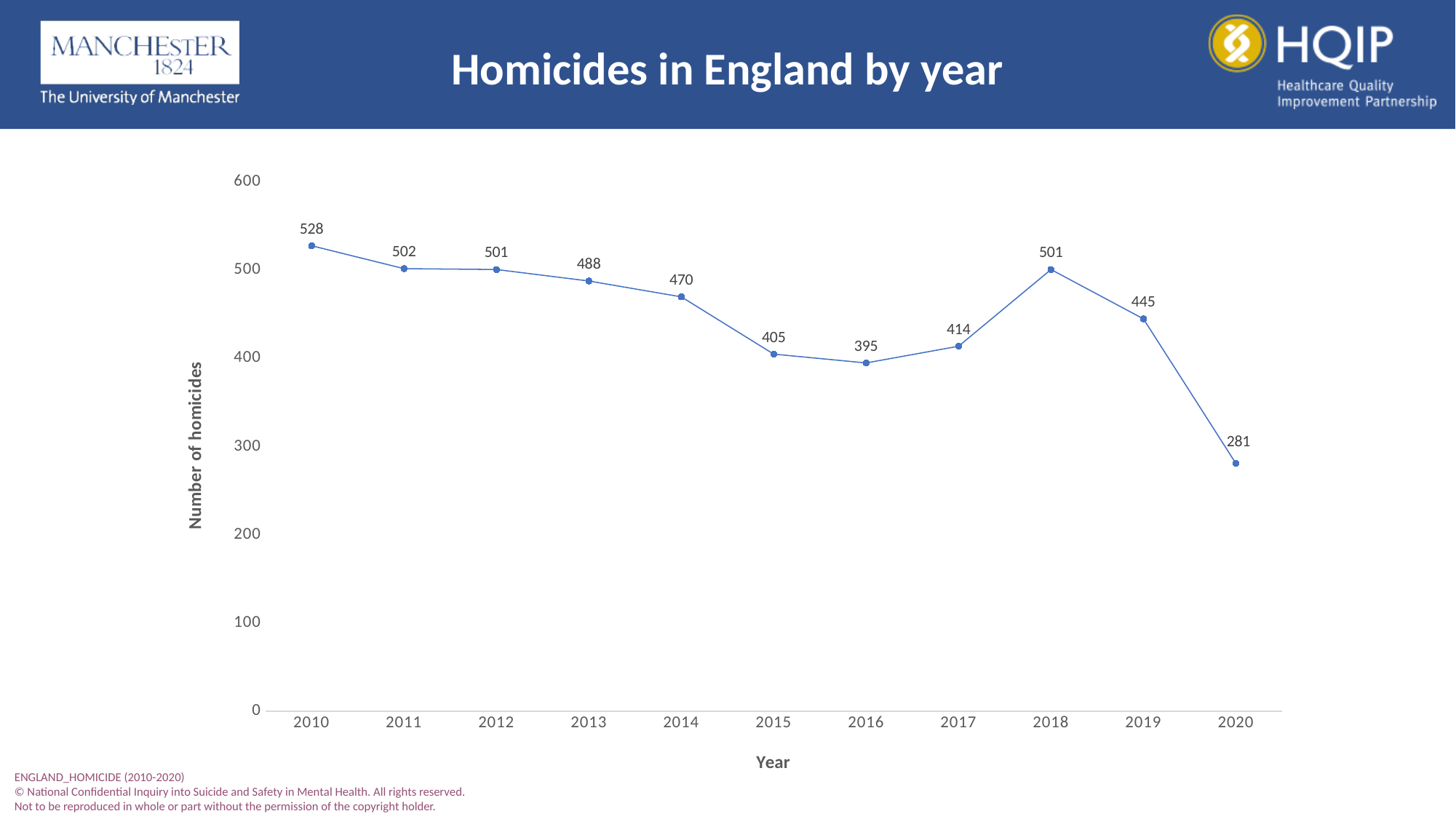
What is the label of the y axis? Number of homicides Which year has the highest number of homicides? 2010 Which year has more homicides, 2015 or 2018? 2018 What is the number of homicides in England in 2010? 528 What is the difference in the number of homicides between 2019 and 2020? 164 Which year has the lowest number of homicides? 2020 What is the number of homicides in England in 2016? 395 How many years are plotted on the chart? 11 Is the number of homicides in 2017 greater or less than 400? greater What is the difference in the number of homicides between 2010 and 2014? 58 What kind of chart is shown on the slide? line chart What is the number of homicides in England in 2020? 281